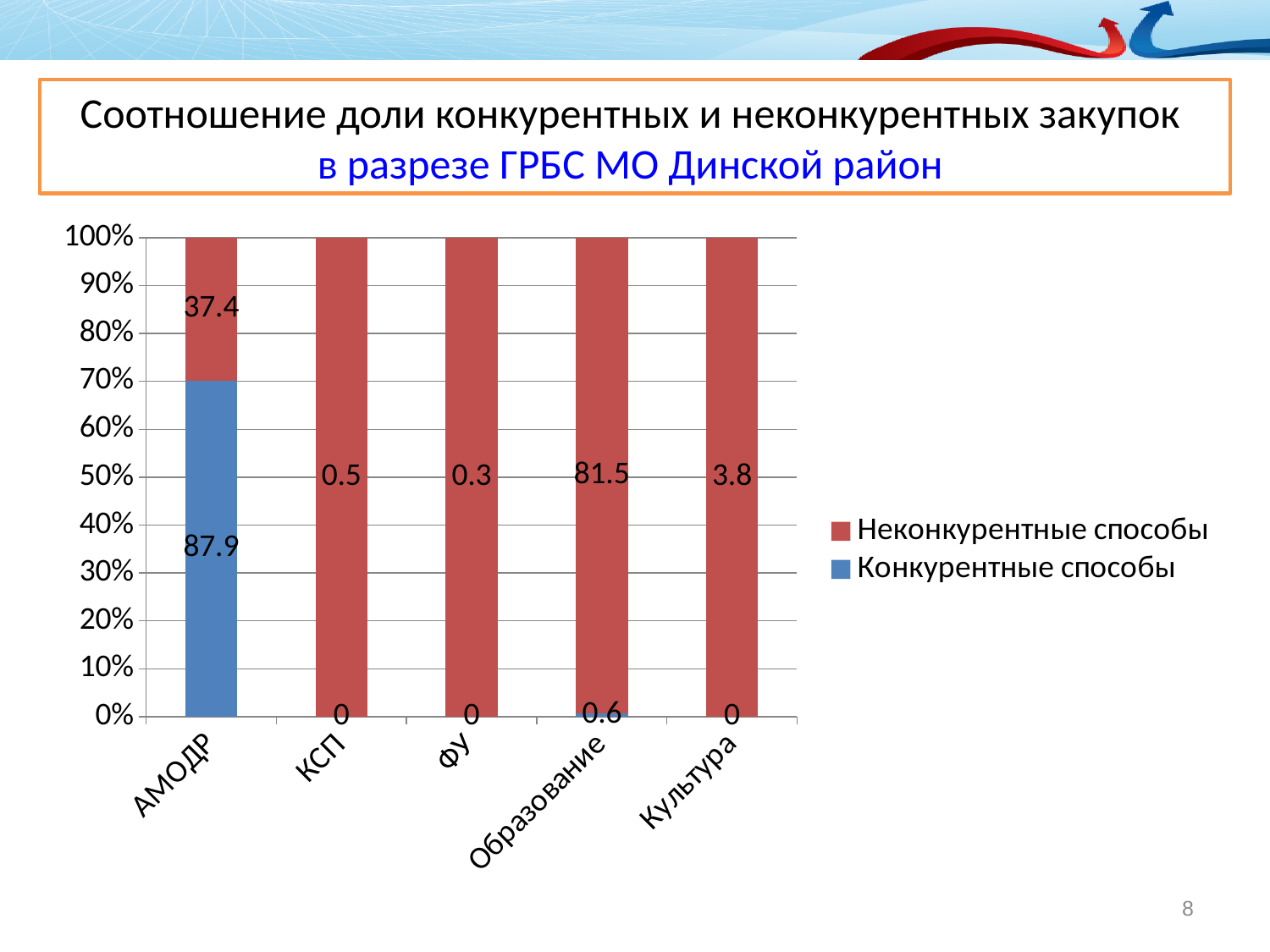
Which category has the lowest value for Неконкурентные способы? ФУ How many categories are shown on the x axis? 5 How many series does the legend list? 2 Which category has the highest value for Неконкурентные способы? Образование What is the value of Неконкурентные способы for Образование? 81.5 What kind of chart is shown on the slide? Stacked bar chart What is the value of Неконкурентные способы for АМОДР? 37.4 What is the difference between the Конкурентные способы and Неконкурентные способы values for АМОДР? 50.5 What is the value of Неконкурентные способы for Культура? 3.8 What is the value of Конкурентные способы for АМОДР? 87.9 What is the value of Конкурентные способы for Образование? 0.6 Which is larger: the Неконкурентные способы value for КСП or for Культура? Культура